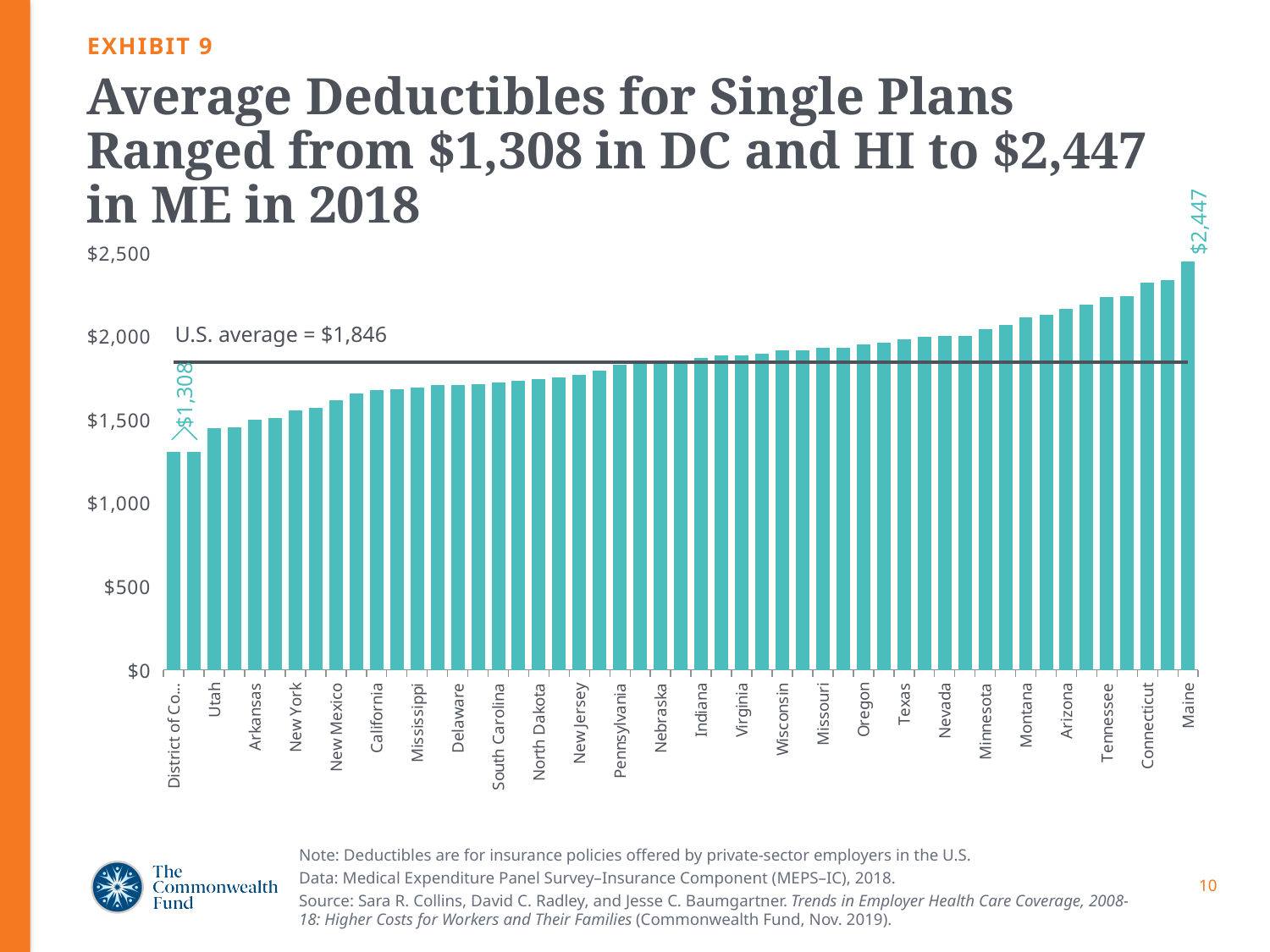
Is the value for Arkansas greater or less than $2,000? less Is the value for Utah greater or less than $1,500? less Which state has the highest average deductible for single plans? Maine What is the average deductible for a single plan in Maine? $2,447 Which has a higher average deductible, Connecticut or California? Connecticut What U.S. average value is marked by the horizontal line on the chart? $1,846 Which has a lower average deductible, Utah or Texas? Utah What is the difference between the average deductible in Maine and in the District of Columbia? $1,139 What kind of chart is shown on the slide? bar chart What is the average deductible for a single plan in the District of Columbia? $1,308 Is the value for Connecticut greater or less than $2,000? greater Do the values rise or fall moving from left to right along the x axis? rise